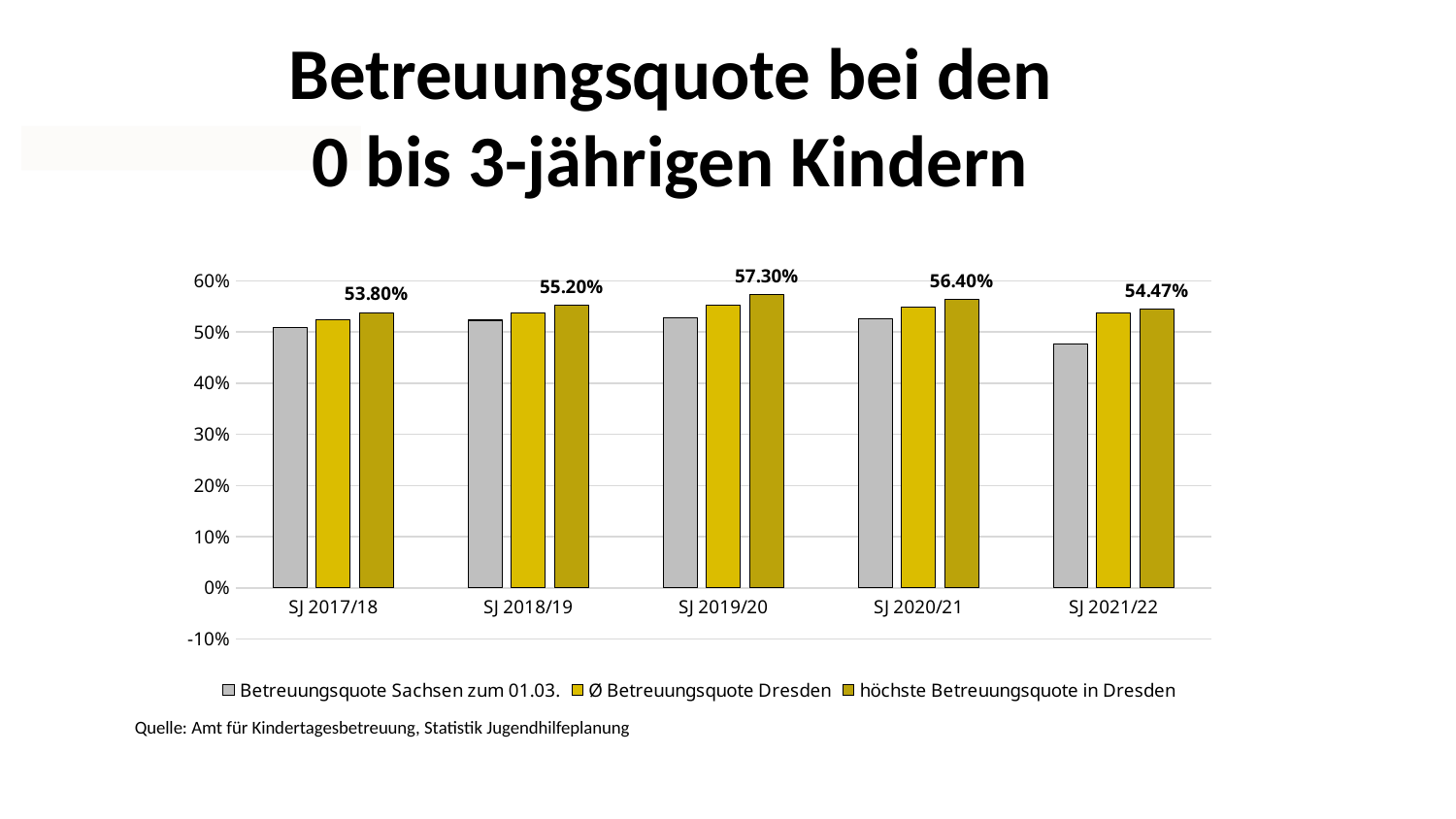
What is the value of 'höchste Betreuungsquote in Dresden' for SJ 2019/20? 57.30% Is the value for 'Betreuungsquote Sachsen zum 01.03.' in SJ 2019/20 greater or less than 50%? greater In which school year is the 'höchste Betreuungsquote in Dresden' the lowest? SJ 2017/18 What kind of chart is shown on the slide? bar chart What is the difference between the 'höchste Betreuungsquote in Dresden' in SJ 2019/20 and in SJ 2017/18? 3.50 percentage points How many school years are shown on the x axis? 5 How many series does the legend list? 3 Is the value for 'Betreuungsquote Sachsen zum 01.03.' in SJ 2021/22 greater or less than 50%? less What is the value of 'höchste Betreuungsquote in Dresden' for SJ 2017/18? 53.80% Which is larger, the 'höchste Betreuungsquote in Dresden' in SJ 2020/21 or in SJ 2021/22? SJ 2020/21 In which school year is the 'höchste Betreuungsquote in Dresden' the highest? SJ 2019/20 Does the 'höchste Betreuungsquote in Dresden' rise or fall from SJ 2017/18 to SJ 2019/20? rise